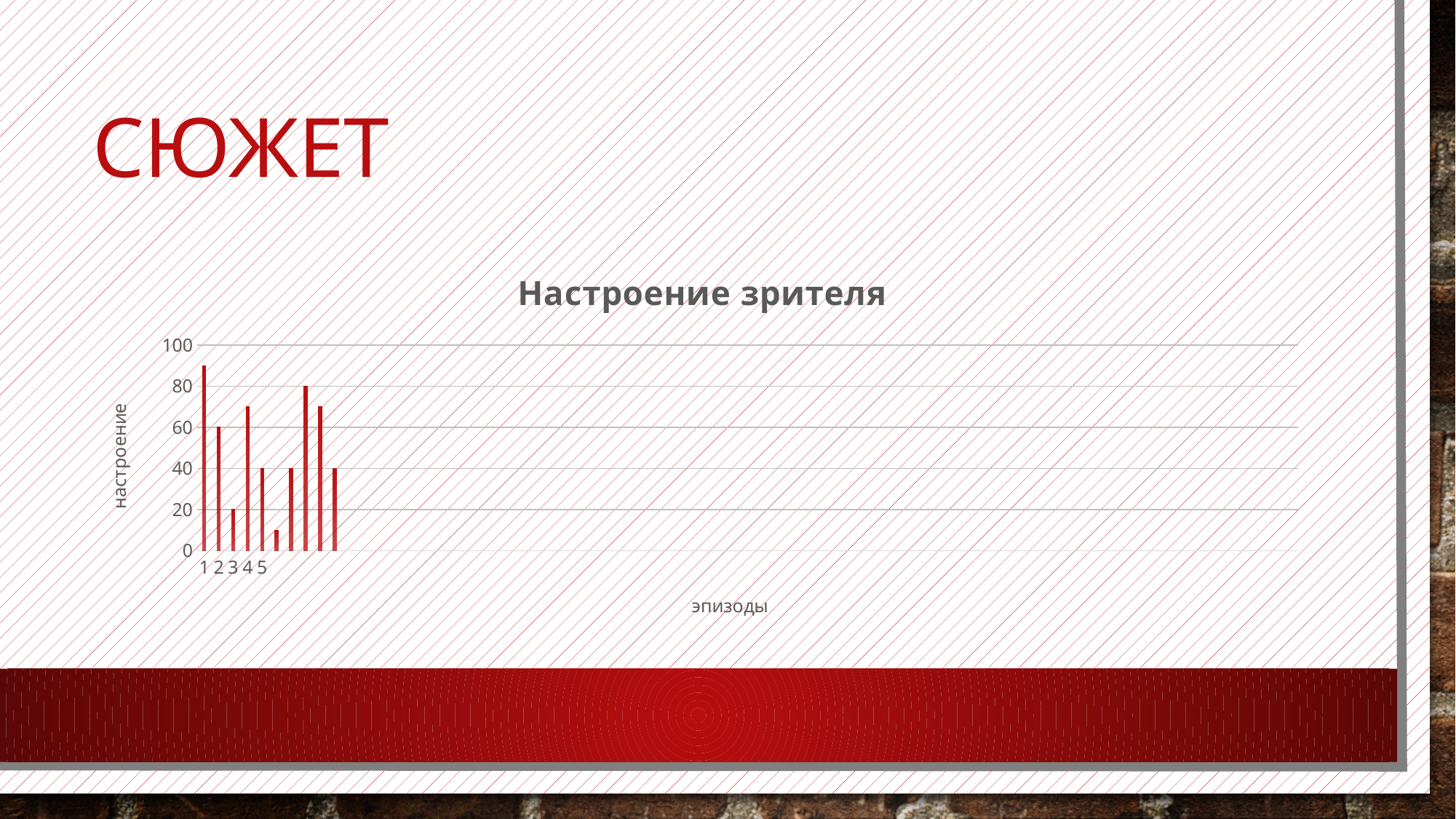
What is the value for category 2? 60 How many bars are plotted in the chart? 10 Do the values rise or fall from category 1 to category 3? fall Is the value for category 1 greater or less than 80? greater Which category has the highest bar in the chart? 1 Is the value for category 3 greater or less than 40? less Is the value for category 4 greater or less than 60? greater What is the label of the horizontal axis of the chart? эпизоды What is the title of the chart? Настроение зрителя Which has the larger value, category 1 or category 2? 1 Which has the larger value, category 4 or category 5? 4 What kind of chart is shown on the slide? bar chart